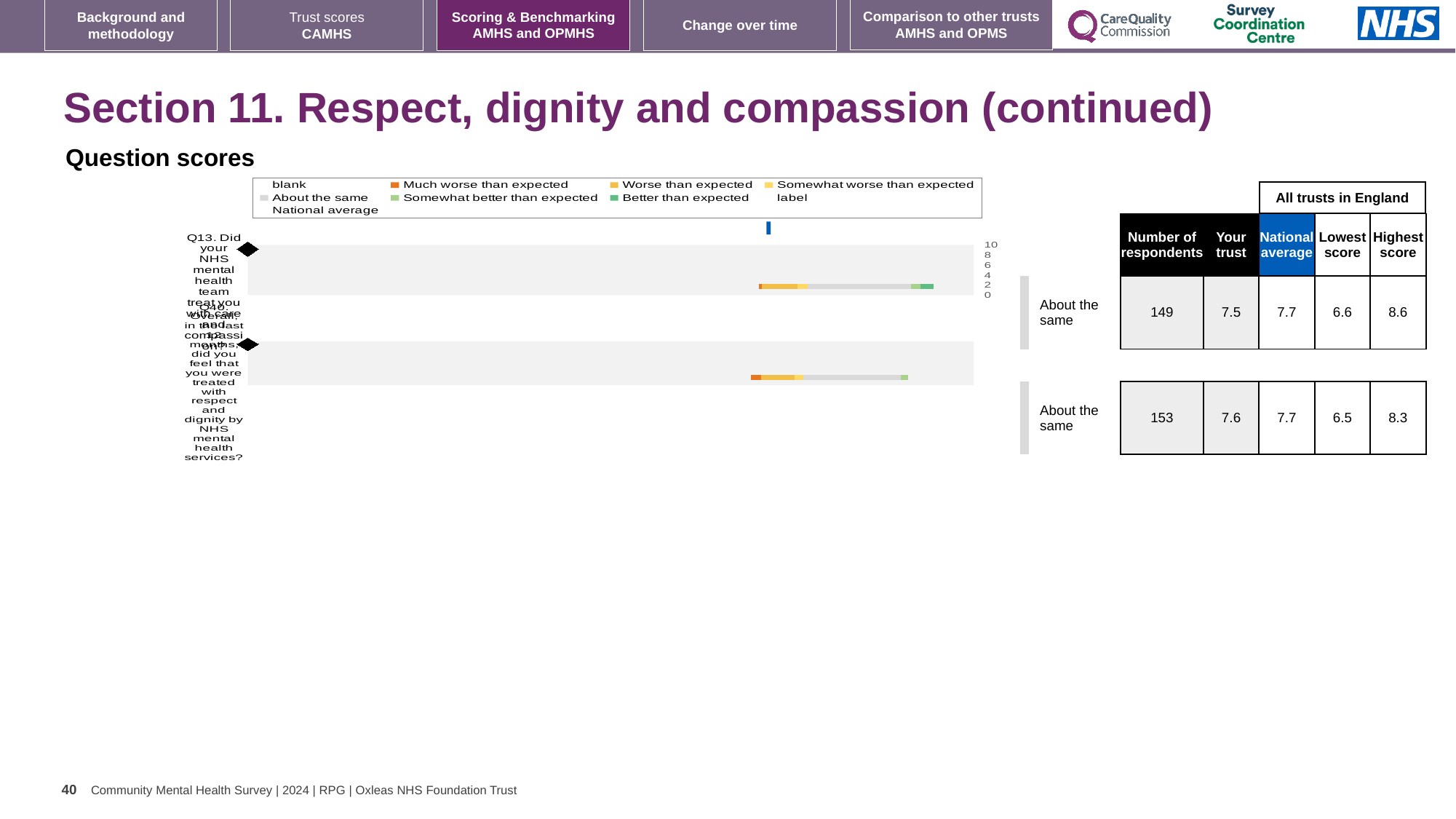
What is the highest score across all trusts in England for the first row (Q13)? 8.6 What benchmark category label is shown next to both rows of the chart? About the same What is the lowest score across all trusts in England for the second row (Q10)? 6.5 What kind of chart is shown under 'Question scores'? bar chart What is the number of respondents for the second row (Q10) in the table? 153 How many questions (categories) are plotted in the chart? 2 What is the number of respondents for the first row (Q13) in the table? 149 In the table beside the chart, what is the 'Your trust' score for the first row (Q13)? 7.5 What is the difference between the highest score and the lowest score for the second row (Q10)? 1.8 Which row has more respondents, the first (Q13) or the second (Q10)? Q10 In the table beside the chart, what is the 'Your trust' score for the second row (Q10)? 7.6 What is the national average score shown for the first row (Q13)? 7.7